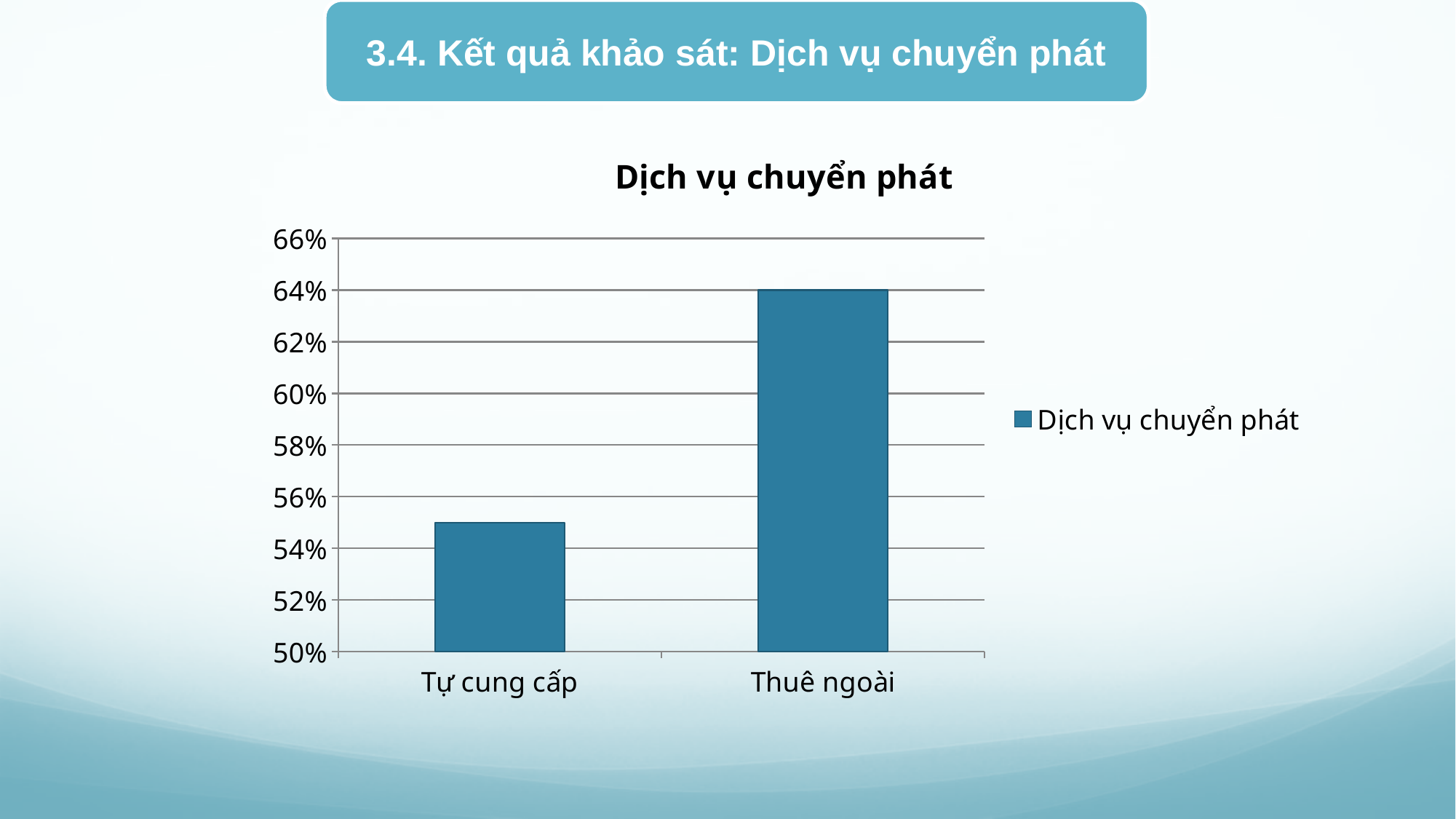
Which category has the highest value in the chart? Thuê ngoài How many categories are plotted on the x axis of the chart? 2 What kind of chart is shown on the slide? Bar chart What is the value for Thuê ngoài? 64% Do the values rise or fall from left to right along the x axis? Rise How many series does the chart's legend list? 1 Which category has the lowest value in the chart? Tự cung cấp What is the title of the chart? Dịch vụ chuyển phát Is the value for Tự cung cấp greater or less than 56%? less Which is larger, the value for Tự cung cấp or the value for Thuê ngoài? Thuê ngoài Is the value for Thuê ngoài greater or less than 60%? greater Is the value for Tự cung cấp greater or less than 54%? greater